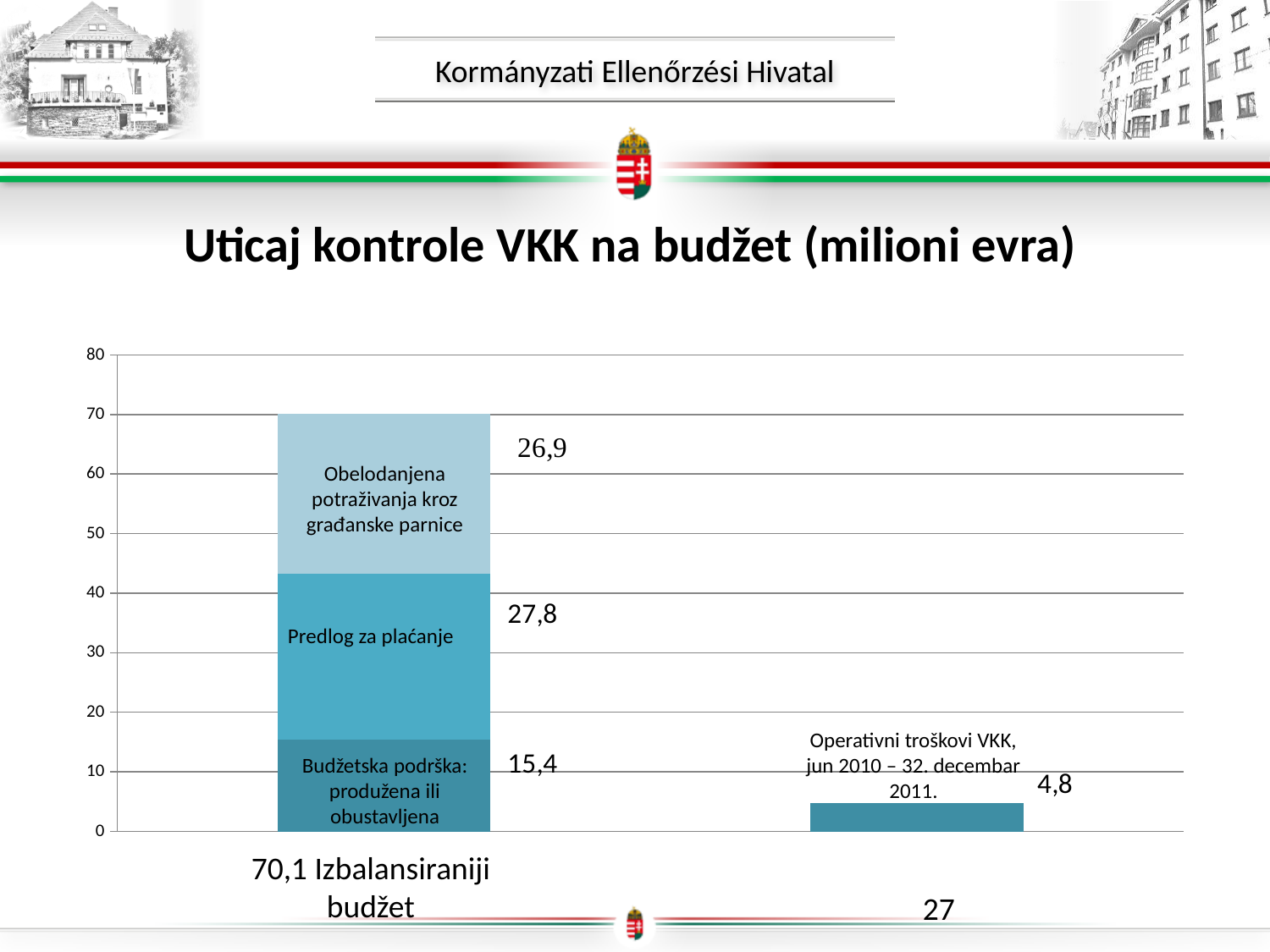
What is the title of the chart on the slide? Uticaj kontrole VKK na budžet (milioni evra) What is the value of the "Obelodanjena potraživanja kroz građanske parnice" segment? 26,9 Which segment of the stacked bar has the smallest value? Budžetska podrška: produžena ili obustavljena What is the difference between the "Predlog za plaćanje" segment (27,8) and the "Budžetska podrška" segment (15,4)? 12,4 What is the value of the "Budžetska podrška: produžena ili obustavljena" segment? 15,4 What is the value of the "Predlog za plaćanje" segment in the stacked bar? 27,8 Which segment of the stacked bar has the largest value? Predlog za plaćanje Is the top of the stacked bar greater or less than 60 on the axis? greater What is the value shown for "Operativni troškovi VKK, jun 2010 – 32. decembar 2011."? 4,8 What kind of chart is shown on the slide? bar chart What is the total of the stacked bar labelled "Izbalansiraniji budžet"? 70,1 Which is larger: the "Budžetska podrška: produžena ili obustavljena" segment or the "Operativni troškovi VKK" bar? Budžetska podrška: produžena ili obustavljena